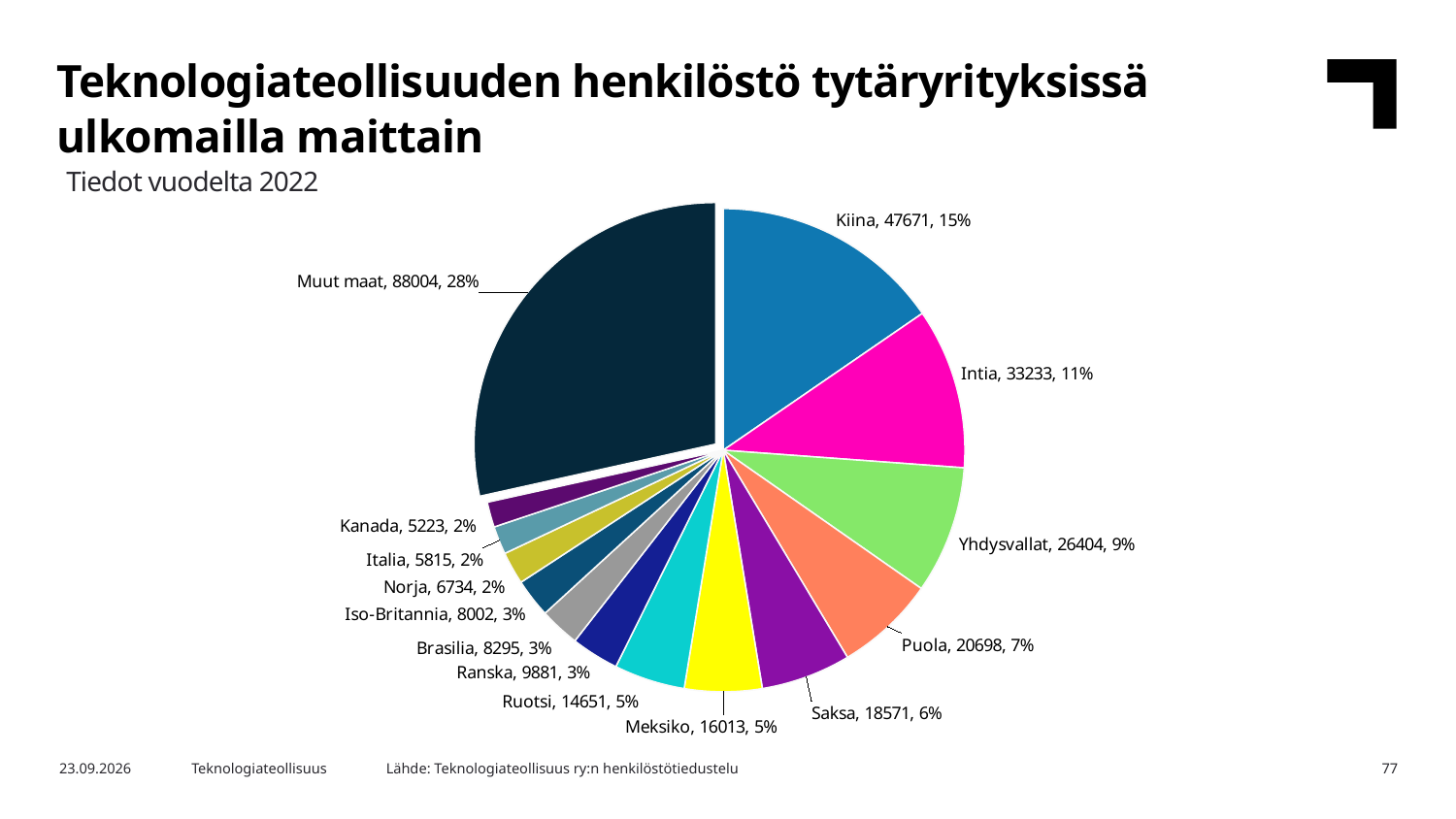
What share of the pie does Intia represent? 11% What is the value for Yhdysvallat? 26404 What is the difference between the values for Kiina and Intia? 14438 How many slices does the pie chart have? 14 Which slice is the smallest in the pie chart? Kanada Which slice is the largest in the pie chart? Muut maat Which is larger, the value for Puola or the value for Saksa? Puola What is the value for Kiina? 47671 What share of the pie does Muut maat represent? 28% What is the value for Meksiko? 16013 What kind of chart is shown on the slide? pie chart What is the title of the chart on the slide? Teknologiateollisuuden henkilöstö tytäryrityksissä ulkomailla maittain